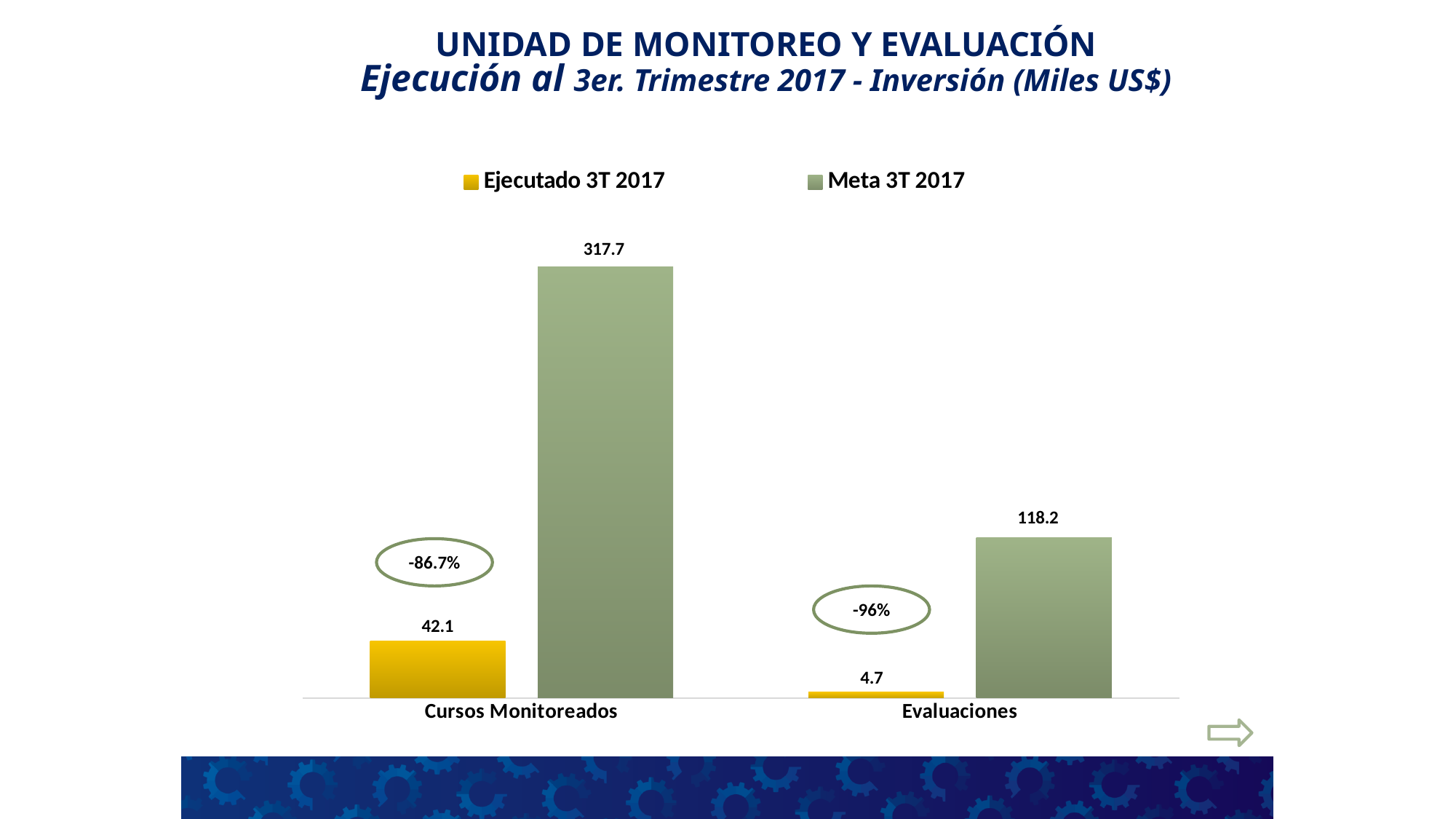
What is the difference between the Meta 3T 2017 and Ejecutado 3T 2017 values for Evaluaciones? 113.5 What kind of chart is shown on the slide? Bar chart Which is larger: the Ejecutado 3T 2017 value for Cursos Monitoreados or the Meta 3T 2017 value for Evaluaciones? Meta 3T 2017 value for Evaluaciones What is the Meta 3T 2017 value for Evaluaciones? 118.2 How many categories are shown on the x axis? 2 What is the Ejecutado 3T 2017 value for Evaluaciones? 4.7 What is the Meta 3T 2017 value for Cursos Monitoreados? 317.7 What is the difference between the Meta 3T 2017 and Ejecutado 3T 2017 values for Cursos Monitoreados? 275.6 How many series does the legend list? 2 What is the Ejecutado 3T 2017 value for Cursos Monitoreados? 42.1 Which category has the lowest Ejecutado 3T 2017 value? Evaluaciones Which category has the highest Meta 3T 2017 value? Cursos Monitoreados